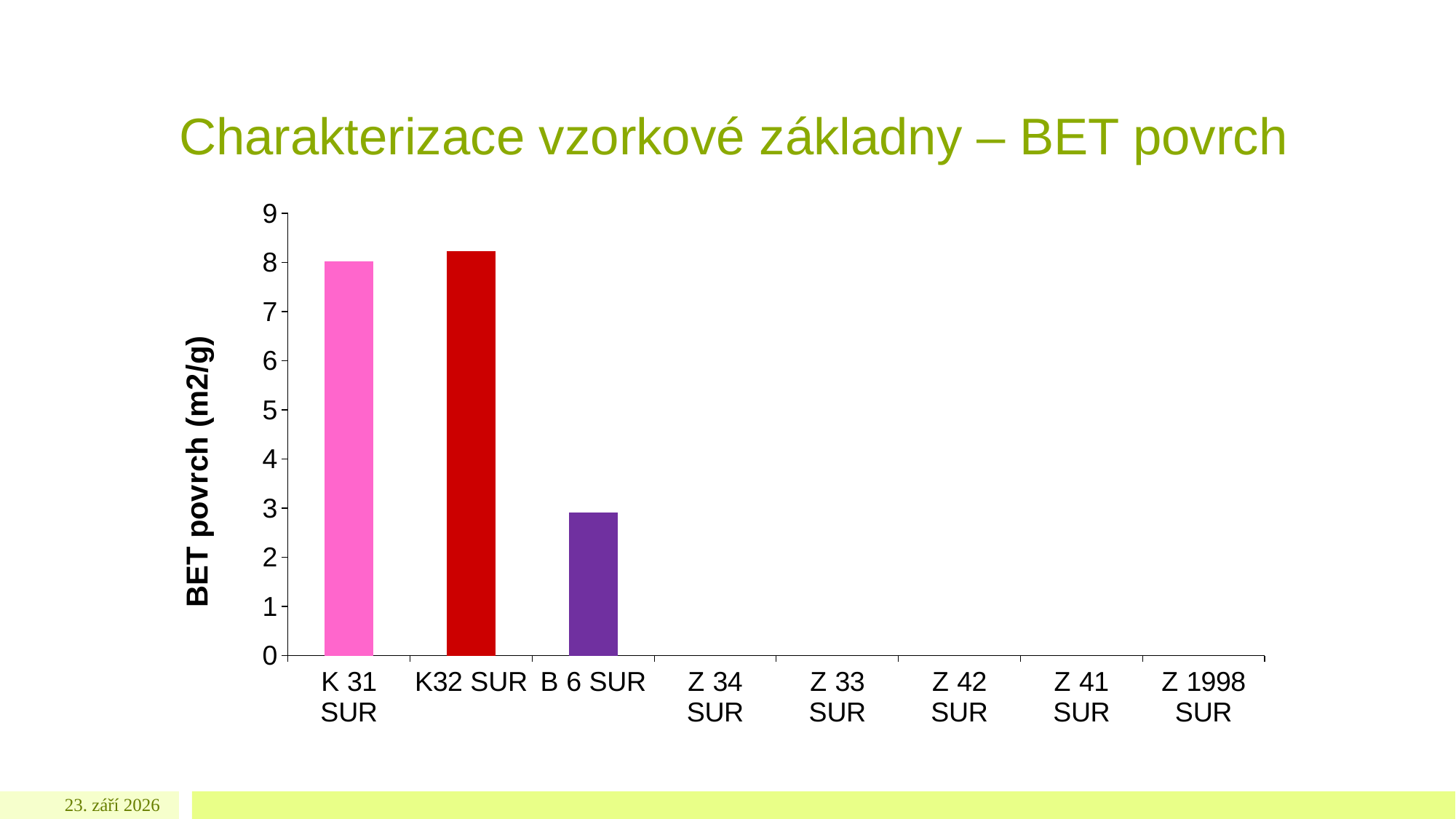
Is the value for K 31 SUR greater or less than 7? greater Is the value for B 6 SUR greater or less than 2? greater Which is larger, the value for K 31 SUR or the value for B 6 SUR? K 31 SUR Is the value for K32 SUR greater or less than 7? greater How many categories have a visible bar in the chart? 3 What colour is the bar for K32 SUR? red Which is larger, the value for K32 SUR or the value for B 6 SUR? K32 SUR What kind of chart is shown on the slide? bar chart What is the label of the vertical axis of the chart? BET povrch (m2/g) How many categories are listed on the x axis of the chart? 8 Which of the three visible bars is the lowest? B 6 SUR